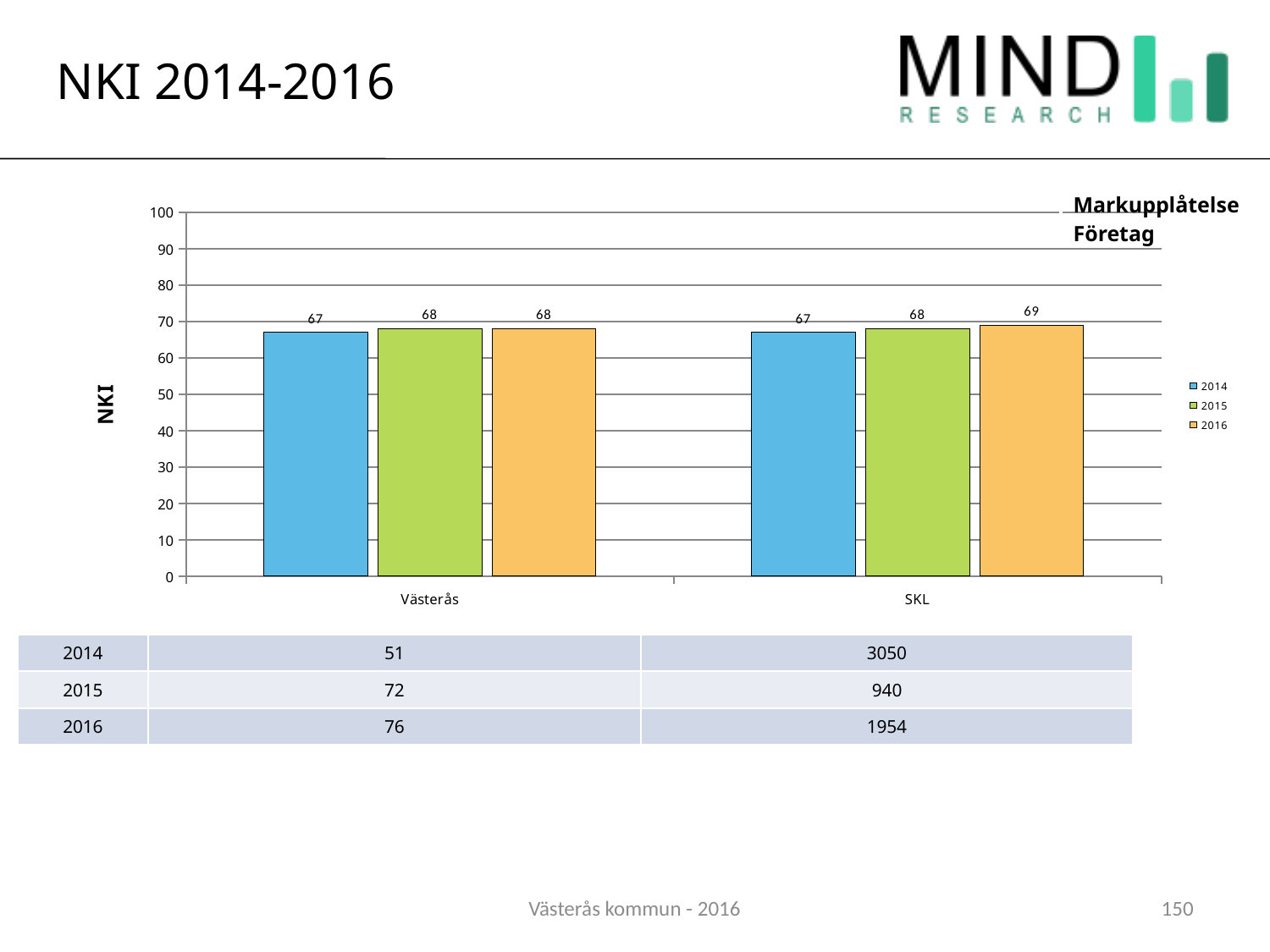
What is the NKI value for SKL in 2015? 68 What is the NKI value for Västerås in 2016? 68 Which is larger, the 2016 value for Västerås or the 2016 value for SKL? SKL What is the NKI value for SKL in 2016? 69 What is the label of the y axis? NKI How many series does the legend list? 3 Which year has the highest NKI value for SKL? 2016 What is the difference between the SKL value in 2016 and the Västerås value in 2016? 1 How many categories are shown on the x axis? 2 What kind of chart is shown on the slide? Bar chart What is the NKI value for Västerås in 2014? 67 Which year has the lowest NKI value for Västerås? 2014